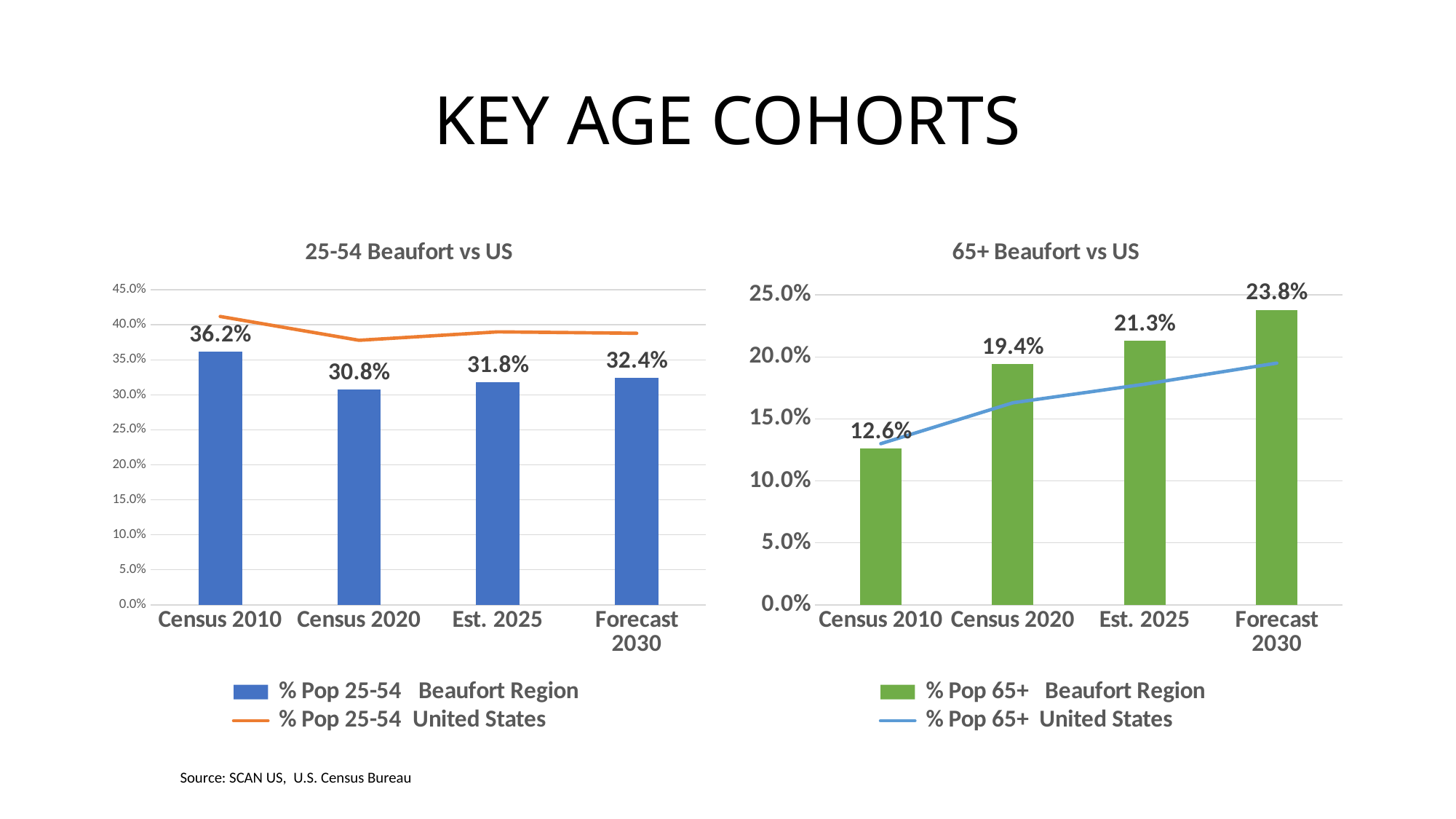
In the '65+ Beaufort vs US' chart, what colour are the bars for the Beaufort Region? green In the '25-54 Beaufort vs US' chart, what is the difference between the Beaufort Region values for Census 2010 and Census 2020? 5.4% In the '65+ Beaufort vs US' chart, how many categories are shown on the x axis? 4 In the '65+ Beaufort vs US' chart, what is the difference between the Beaufort Region values for Est. 2025 and Census 2020? 1.9% In the '25-54 Beaufort vs US' chart, which category has the lowest Beaufort Region value? Census 2020 In the '65+ Beaufort vs US' chart, what is the Beaufort Region value for Forecast 2030? 23.8% In the '25-54 Beaufort vs US' chart, what is the value for the Beaufort Region at Census 2010? 36.2% In the '65+ Beaufort vs US' chart, is the United States value at Forecast 2030 greater or less than 20.0%? less In the '25-54 Beaufort vs US' chart, is the United States value at Census 2010 greater or less than 40.0%? greater In the '65+ Beaufort vs US' chart, do the Beaufort Region values rise or fall from Census 2010 to Forecast 2030? rise In the '25-54 Beaufort vs US' chart, how many series does the legend list? 2 In the '65+ Beaufort vs US' chart, which category has the highest Beaufort Region value? Forecast 2030